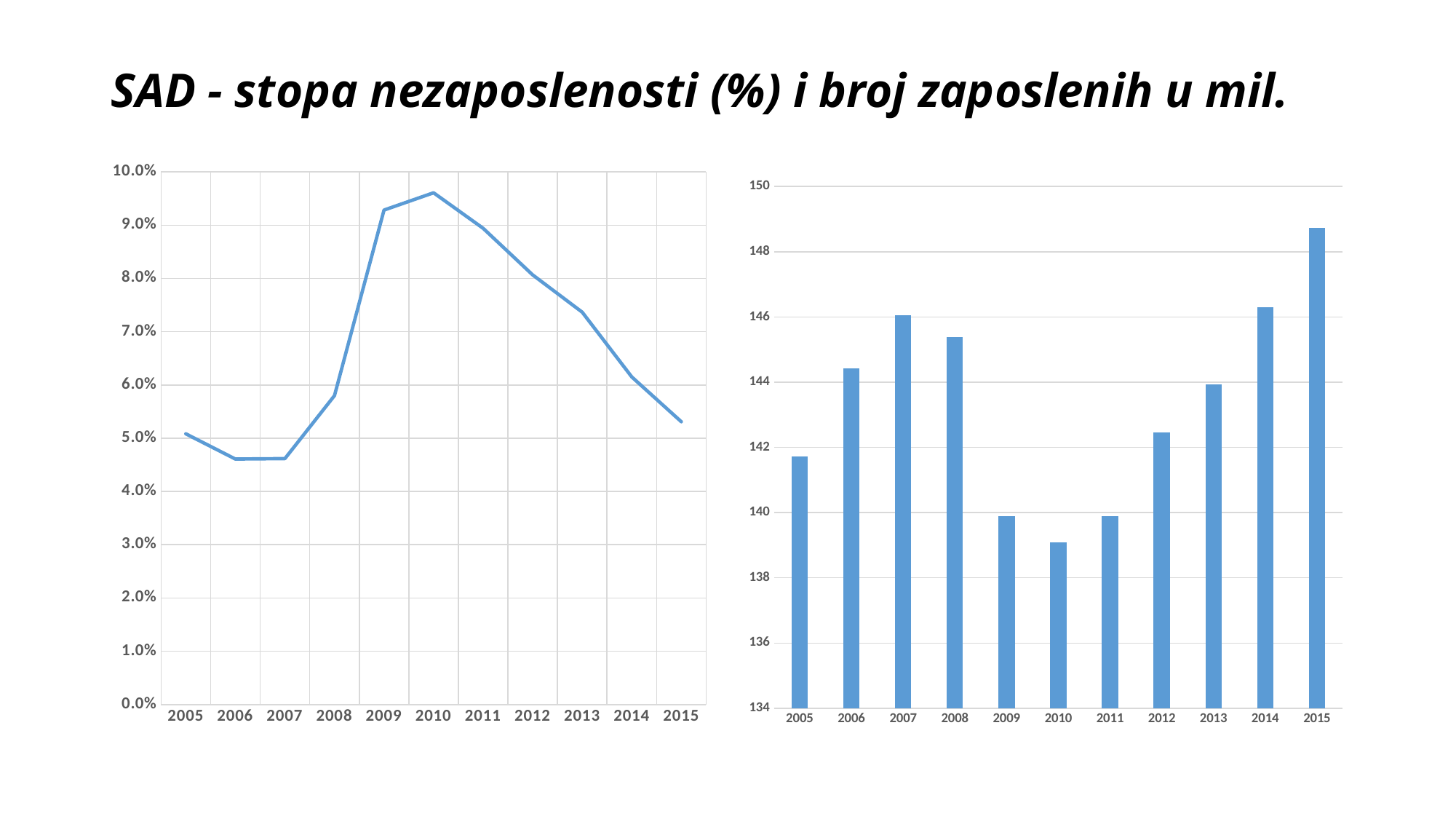
What kind of chart is the chart on the right of the slide? bar chart What kind of chart is the chart on the left of the slide? line chart In the line chart on the left, is the value for 2010 greater or less than 9.0%? greater In the bar chart on the right, which year has the lowest value? 2010 In the line chart on the left, do the values rise or fall from 2010 to 2015? fall In the line chart on the left, is the value for 2006 greater or less than 5.0%? less In the bar chart on the right, is the value for 2010 greater or less than 140? less In the bar chart on the right, which is larger, the value for 2014 or the value for 2015? 2015 How many years are plotted in the bar chart on the right? 11 In the bar chart on the right, which year has the highest value? 2015 In the line chart on the left, which year has the highest unemployment rate? 2010